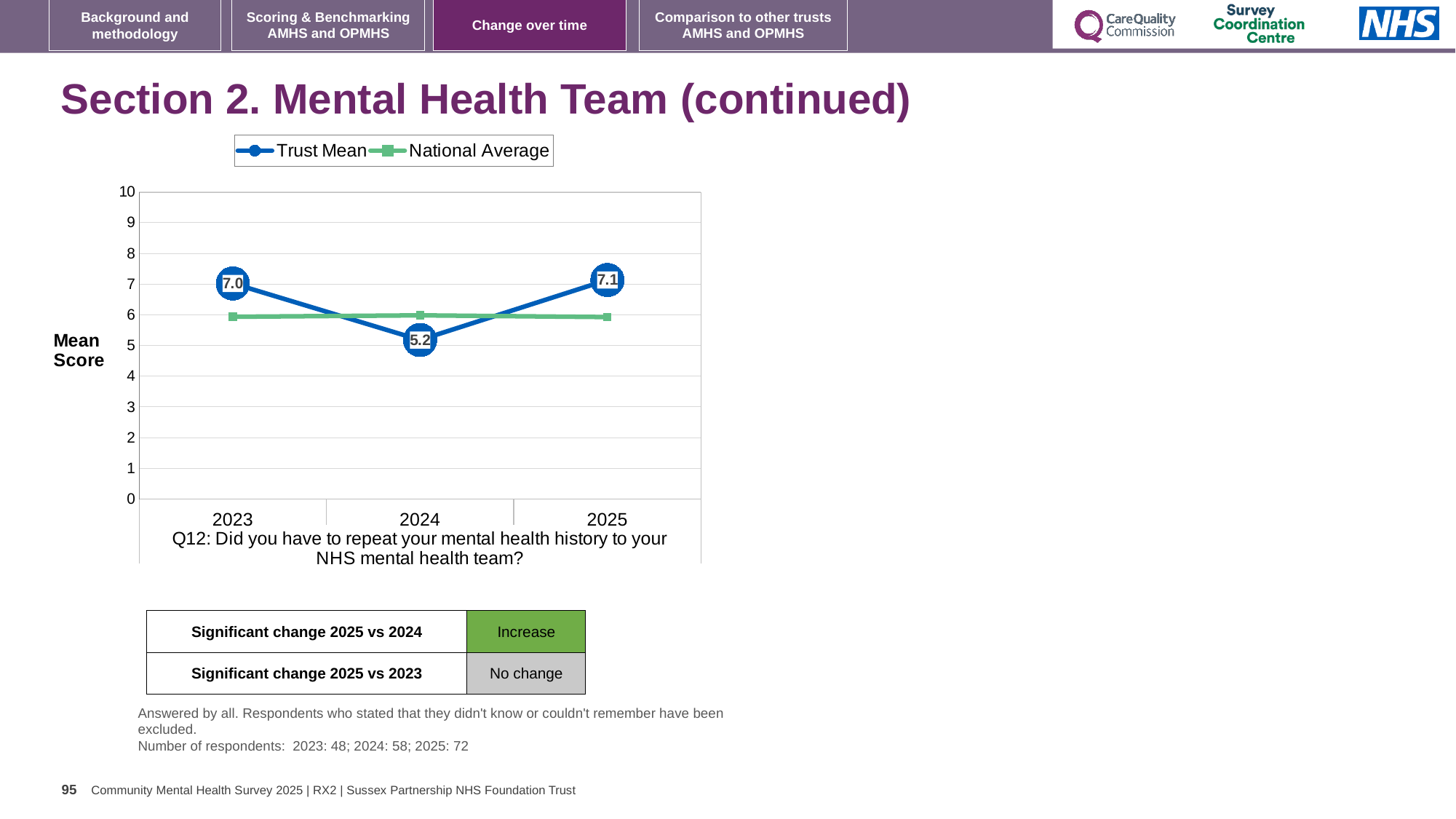
What is the difference between the Trust Mean in 2025 and in 2024? 1.9 In which year is the Trust Mean lowest? 2024 Is the Trust Mean for 2024 greater or less than the National Average for 2024? less Is the Trust Mean for 2025 greater or less than the National Average for 2025? greater What kind of chart is shown? line chart What is the Trust Mean score for 2024? 5.2 What is the Trust Mean score for 2023? 7.0 How many series does the legend list? 2 Is the National Average for 2023 greater or less than 7? less Which series is shown in green in the legend? National Average What is the Trust Mean score for 2025? 7.1 How many years are shown on the x axis? 3